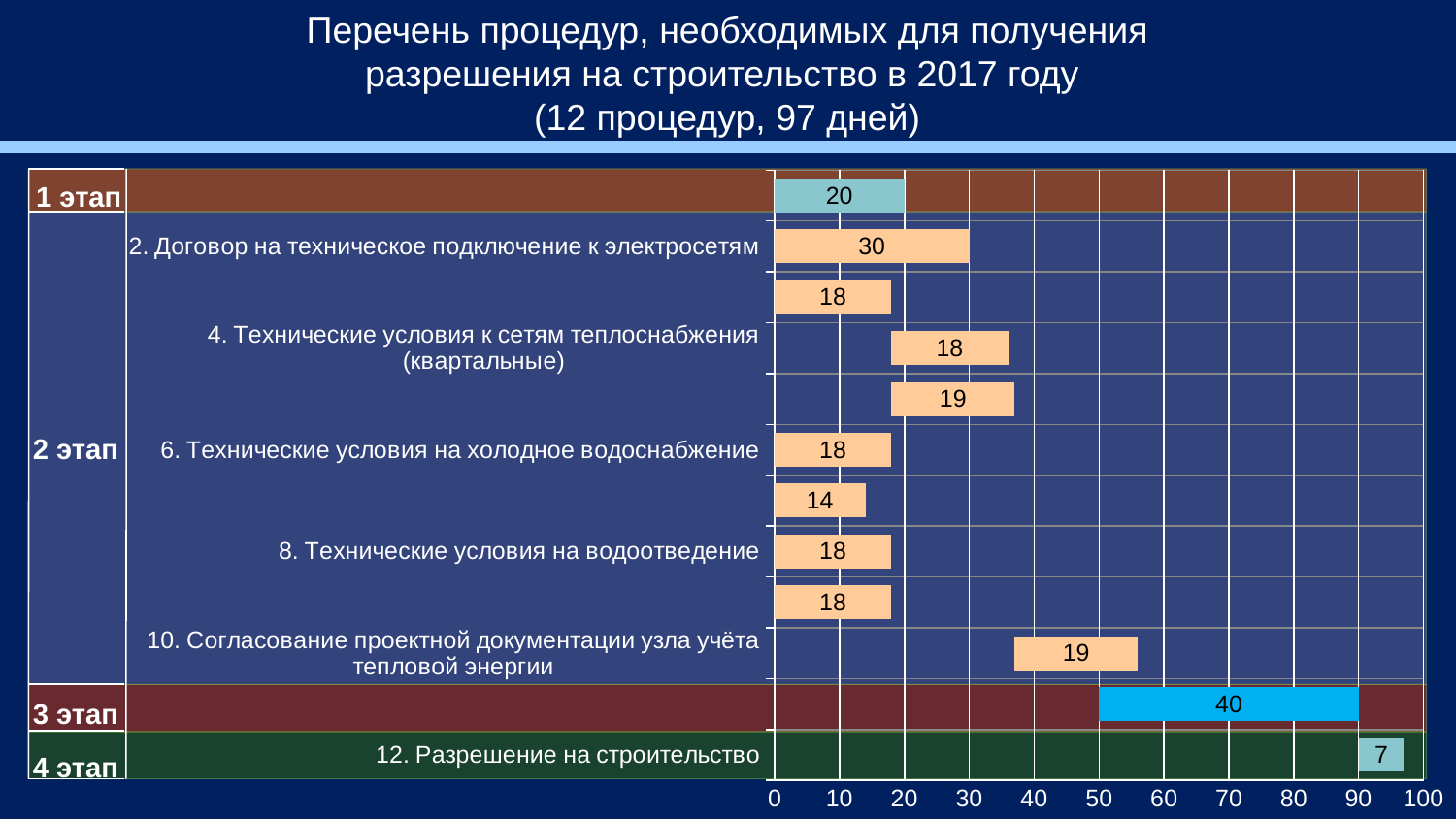
What is the value shown for "10. Согласование проектной документации узла учёта тепловой энергии"? 19 What is the difference between the value for "2. Договор на техническое подключение к электросетям" and the value for "8. Технические условия на водоотведение"? 12 Which bar has the largest value on the chart? 3 этап (40) What kind of chart is shown on the slide? Bar chart How many bars are plotted on the chart? 12 Which is larger: the value for "2. Договор на техническое подключение к электросетям" or the value for "4. Технические условия к сетям теплоснабжения (квартальные)"? 2. Договор на техническое подключение к электросетям What is the value shown for "12. Разрешение на строительство"? 7 What is the value of the bar in the "1 этап" row? 20 What is the value shown for "6. Технические условия на холодное водоснабжение"? 18 Which bar has the smallest value on the chart? 12. Разрешение на строительство (7) What is the value of the bar in the "3 этап" row? 40 What is the value shown for "2. Договор на техническое подключение к электросетям"? 30